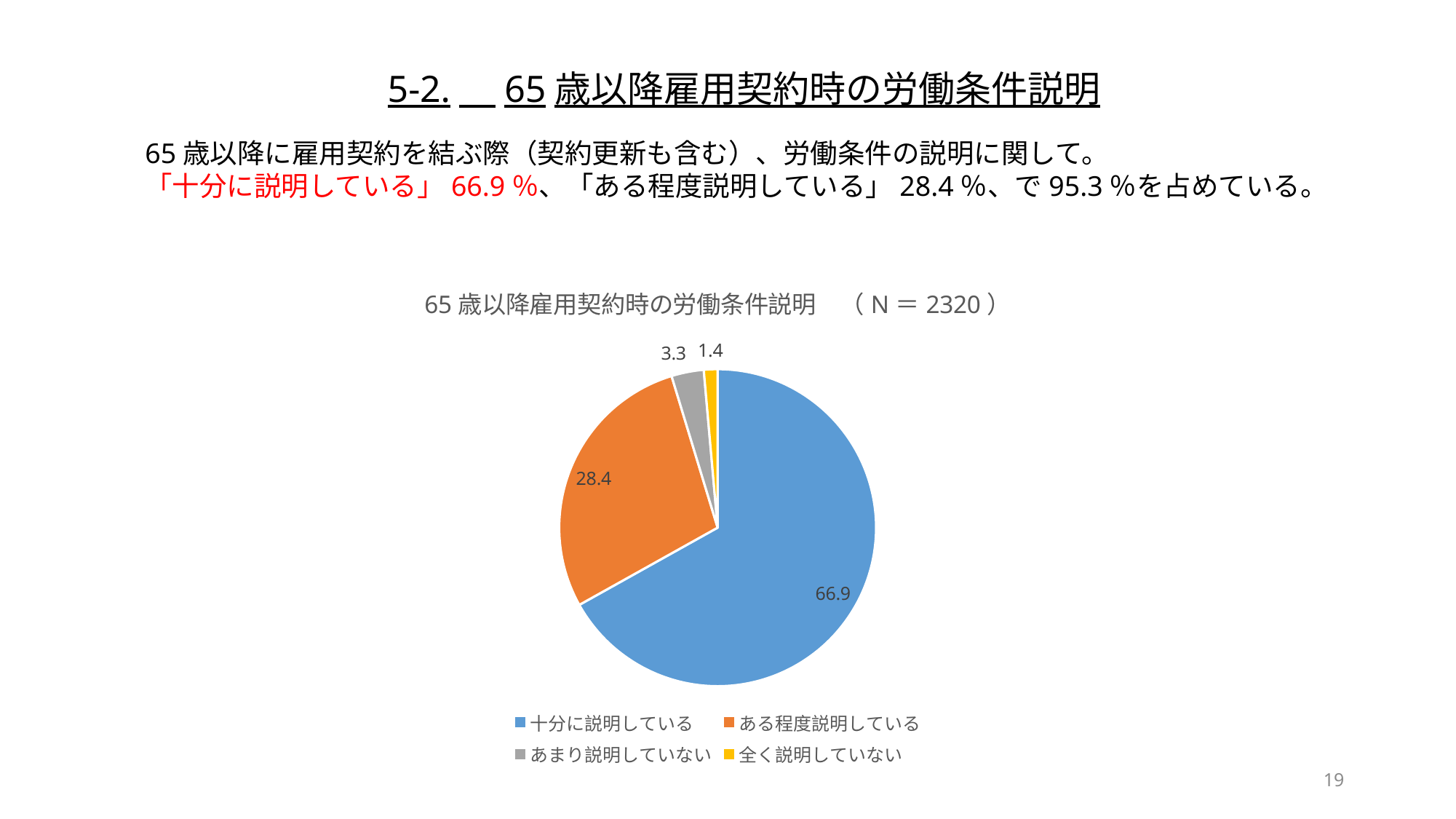
What is the value for 全く説明していない? 1.4 What kind of chart is shown on the slide? pie chart What colour is the slice for ある程度説明している? orange What is the value for ある程度説明している? 28.4 Which category has the smallest slice? 全く説明していない Which is larger, あまり説明していない or 全く説明していない? あまり説明していない What is the N value shown in the chart title? 2320 Which category has the largest slice? 十分に説明している What is the value for あまり説明していない? 3.3 What is the value for 十分に説明している? 66.9 How many categories does the pie chart have? 4 What is the difference between the values for 十分に説明している and ある程度説明している? 38.5